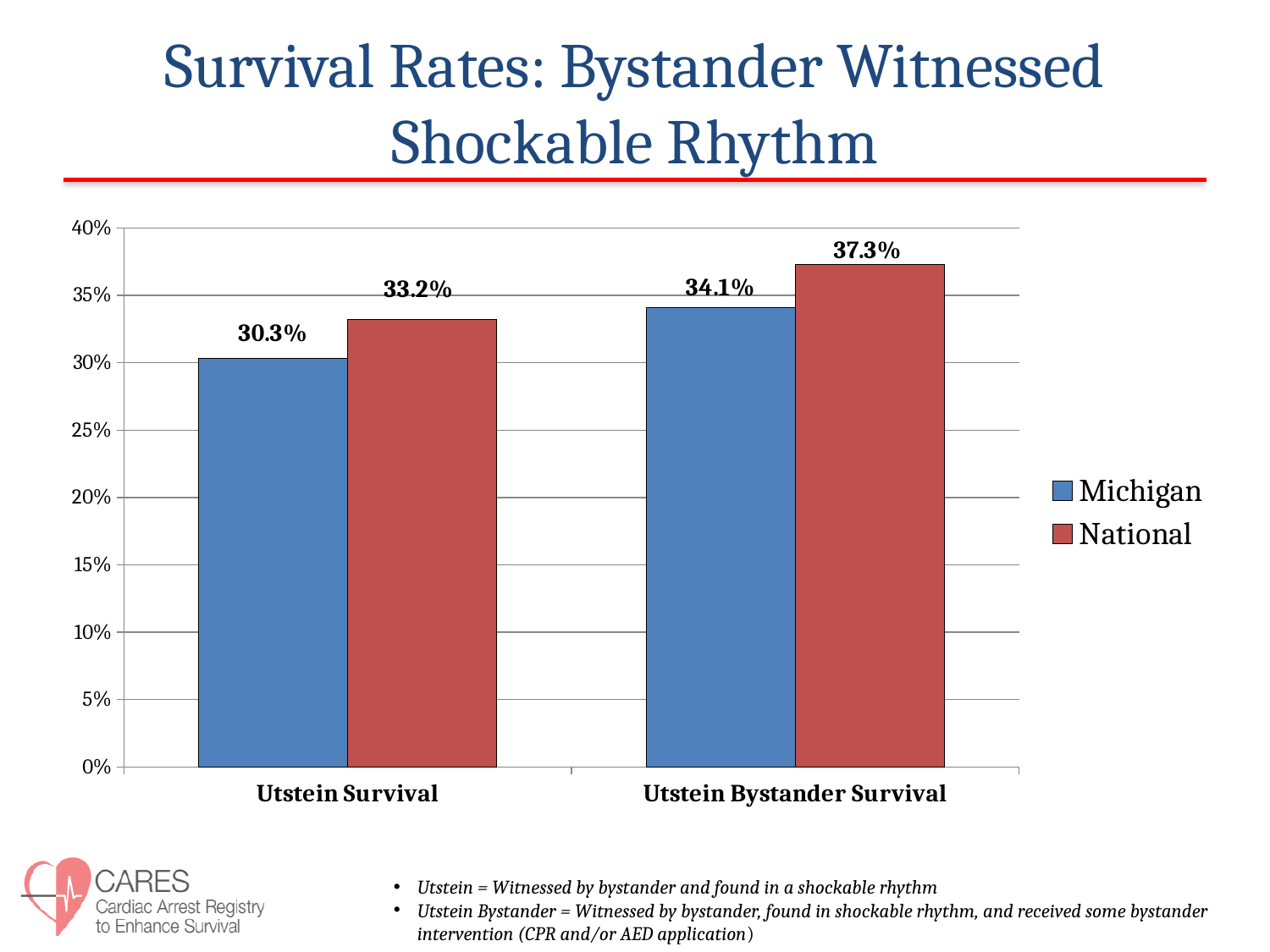
How many series does the legend list? 2 Which bar has the highest value on the chart? National, Utstein Bystander Survival How many categories are shown on the x axis? 2 Which colour represents National in the chart? Red What is the National value for Utstein Bystander Survival? 37.3% Which bar has the lowest value on the chart? Michigan, Utstein Survival What is the National value for Utstein Survival? 33.2% What is the difference between the National and Michigan values for Utstein Bystander Survival? 3.2% Which is larger for Utstein Survival, Michigan or National? National What is the Michigan value for Utstein Survival? 30.3% What is the Michigan value for Utstein Bystander Survival? 34.1% What kind of chart is shown on the slide? Bar chart